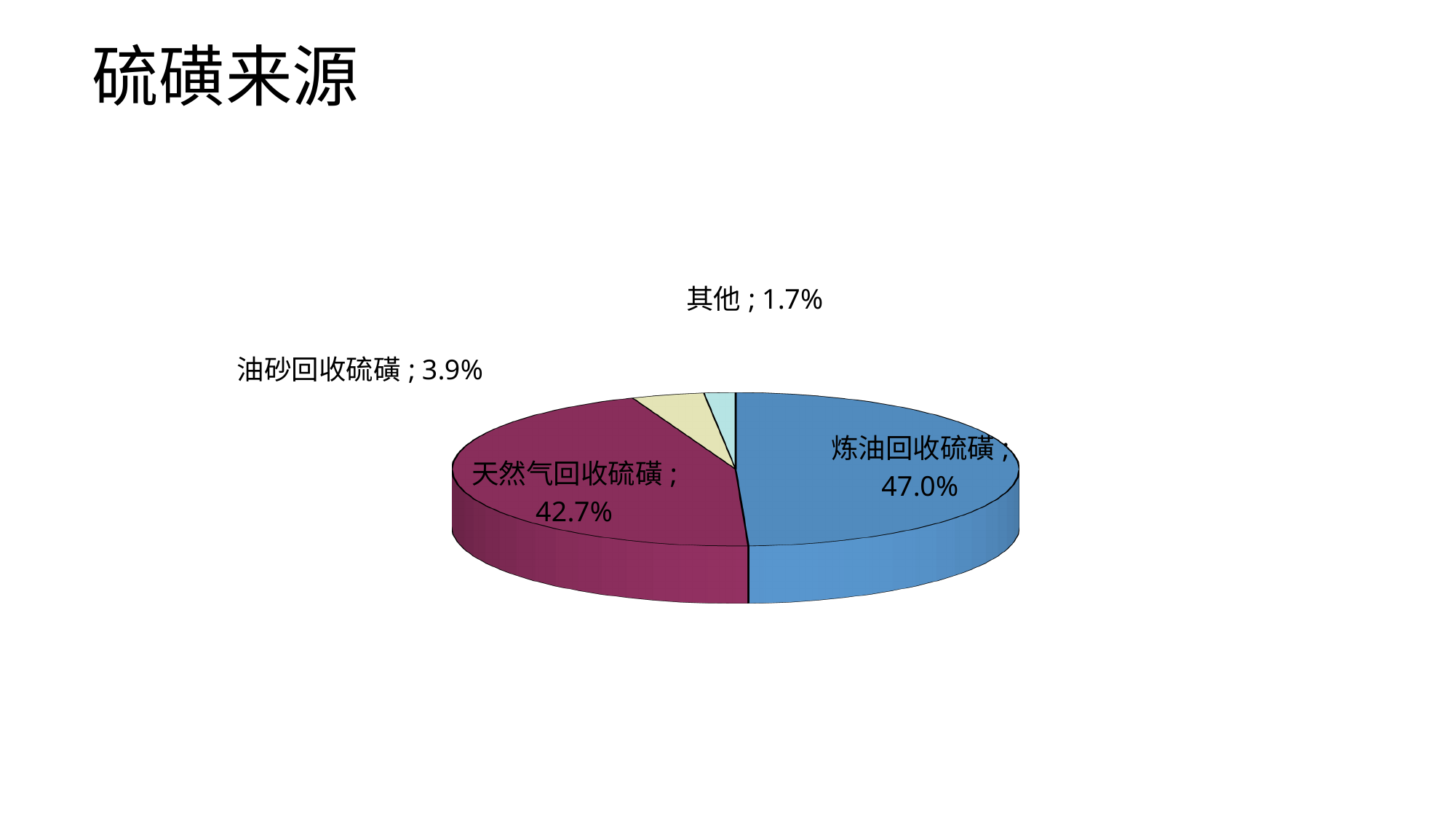
Which category has the largest slice of the pie? 炼油回收硫磺 What kind of chart is shown on the slide? Pie chart What is the value shown for 油砂回收硫磺? 3.9% Which category has the smallest slice of the pie? 其他 What is the value shown for 其他? 1.7% How many categories are shown in the pie chart? 4 What is the title of the slide containing the chart? 硫磺来源 What is the value shown for 天然气回收硫磺? 42.7% What is the difference between the shares of 油砂回收硫磺 and 其他? 2.2% Which is larger, the share of 油砂回收硫磺 or the share of 其他? 油砂回收硫磺 What is the difference between the shares of 炼油回收硫磺 and 天然气回收硫磺? 4.3% What share of the pie does 炼油回收硫磺 account for? 47.0%